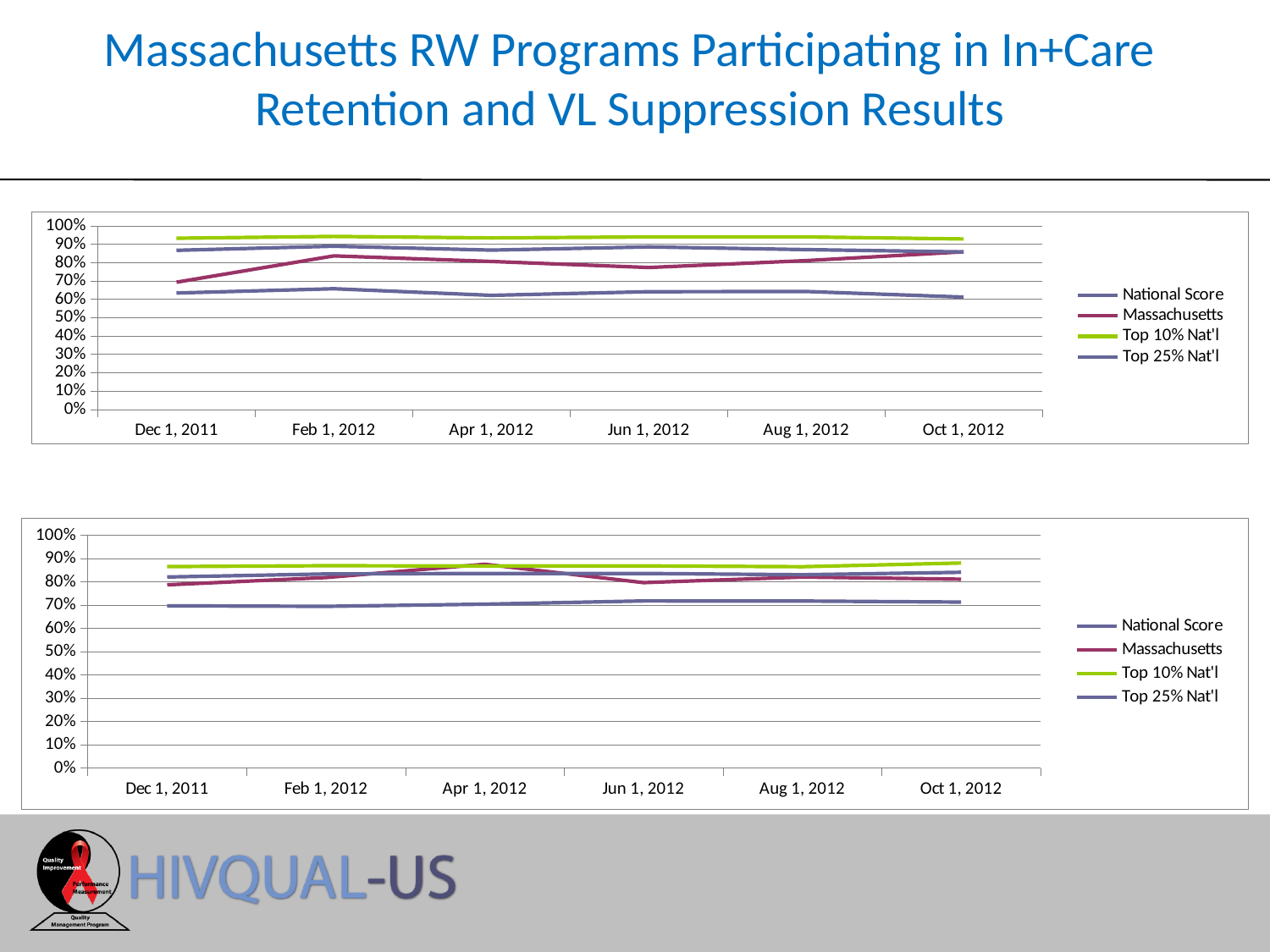
How many dates are shown on the x axis of the top chart? 6 In the bottom chart, is the value for Massachusetts at Apr 1, 2012 greater or less than 80%? greater In the top chart, does the Massachusetts line rise or fall from Dec 1, 2011 to Feb 1, 2012? rise What kind of chart is the top chart on the slide? line chart In the top chart, which series is the lowest across all dates? National Score In the top chart, at Dec 1, 2011, which is larger: Massachusetts or Top 25% Nat'l? Top 25% Nat'l In the top chart, which series is the highest across all dates? Top 10% Nat'l In the bottom chart, at Jun 1, 2012, which is larger: Massachusetts or National Score? Massachusetts In the bottom chart, which series is the lowest across all dates? National Score How many series does the legend of the bottom chart list? 4 In the top chart, is the value for National Score at Dec 1, 2011 greater or less than 70%? less In the top chart, is the value for Top 10% Nat'l at Dec 1, 2011 greater or less than 90%? greater